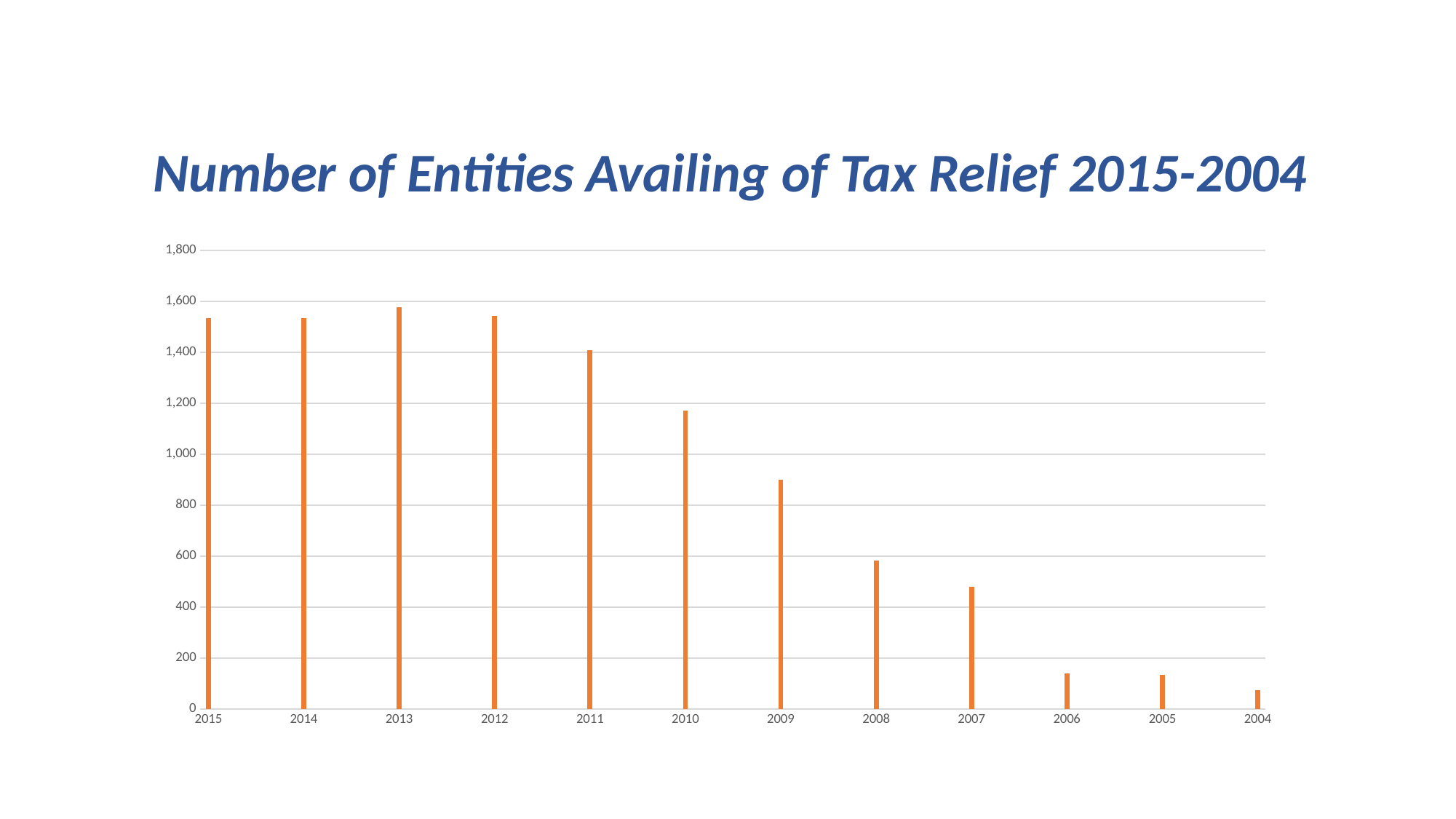
Moving from left (2015) to right (2004) along the x axis, do the values generally rise or fall? Fall Which year has a larger value, 2008 or 2007? 2008 Which year has the lowest number of entities availing of tax relief? 2004 How many years are shown on the x axis of the chart? 12 Is the value for 2009 greater or less than 1,000? less What is the title of the chart? Number of Entities Availing of Tax Relief 2015-2004 Is the value for 2007 greater or less than 400? greater Is the value for 2006 greater or less than 200? less Which year has a larger value, 2010 or 2009? 2010 What kind of chart is shown on the slide? Bar chart Which year has the highest number of entities availing of tax relief? 2013